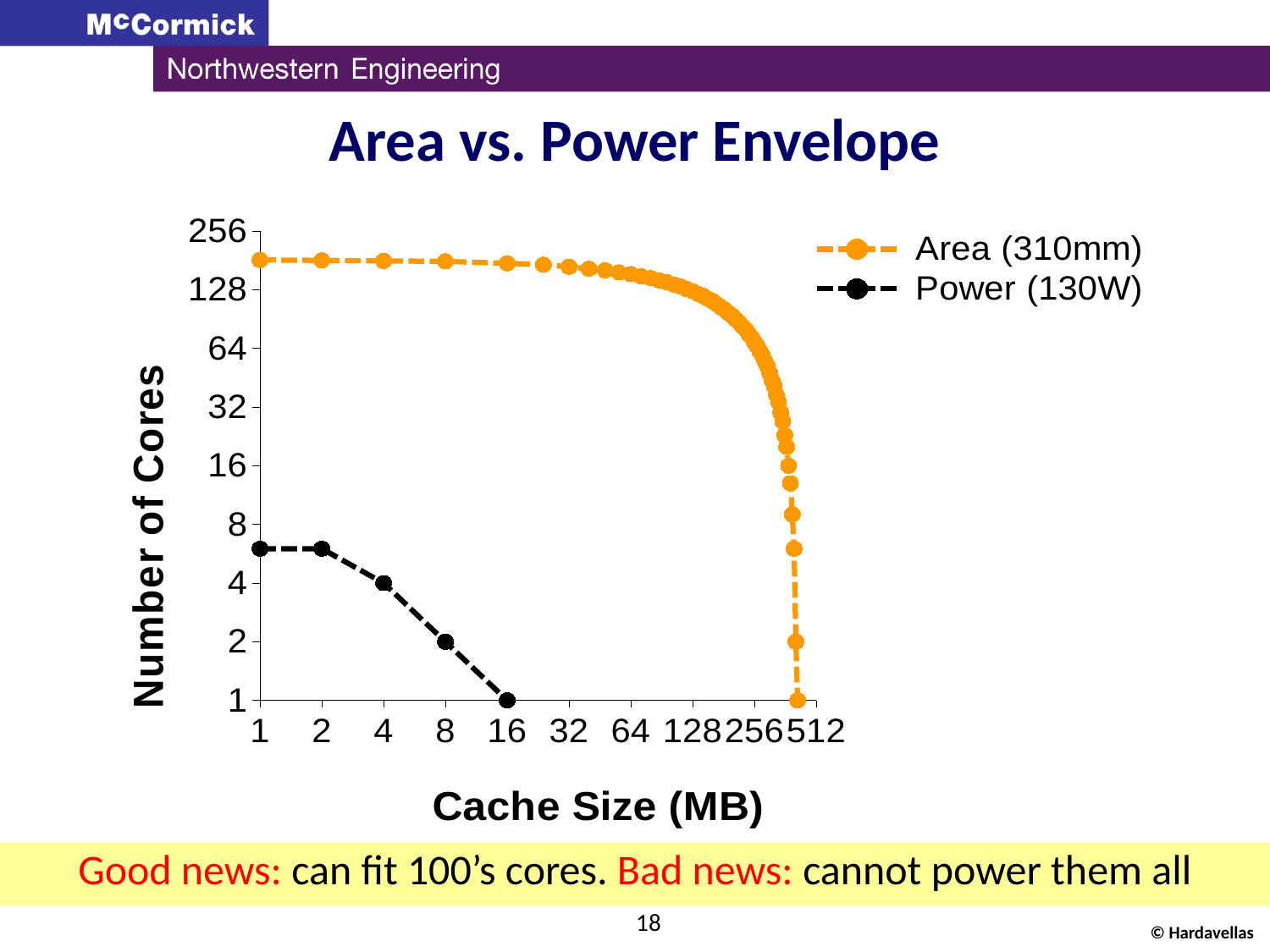
Does the Power (130W) series rise or fall as cache size increases? falls What is the number of cores for the Power (130W) series at a cache size of 4 MB? 4 At a cache size of 4 MB, which series has the higher number of cores? Area (310mm) What are the two series named in the legend? Area (310mm) and Power (130W) What is the number of cores for the Power (130W) series at a cache size of 8 MB? 2 Does the Area (310mm) series rise or fall as cache size increases? falls What is the number of cores for the Power (130W) series at a cache size of 16 MB? 1 What is the title of the x axis? Cache Size (MB) Is the value for the Power (130W) series at a cache size of 1 MB greater or less than 8? less What kind of chart is shown on the slide? line chart How many series does the legend list? 2 Is the value for the Area (310mm) series at a cache size of 1 MB greater or less than 128? greater